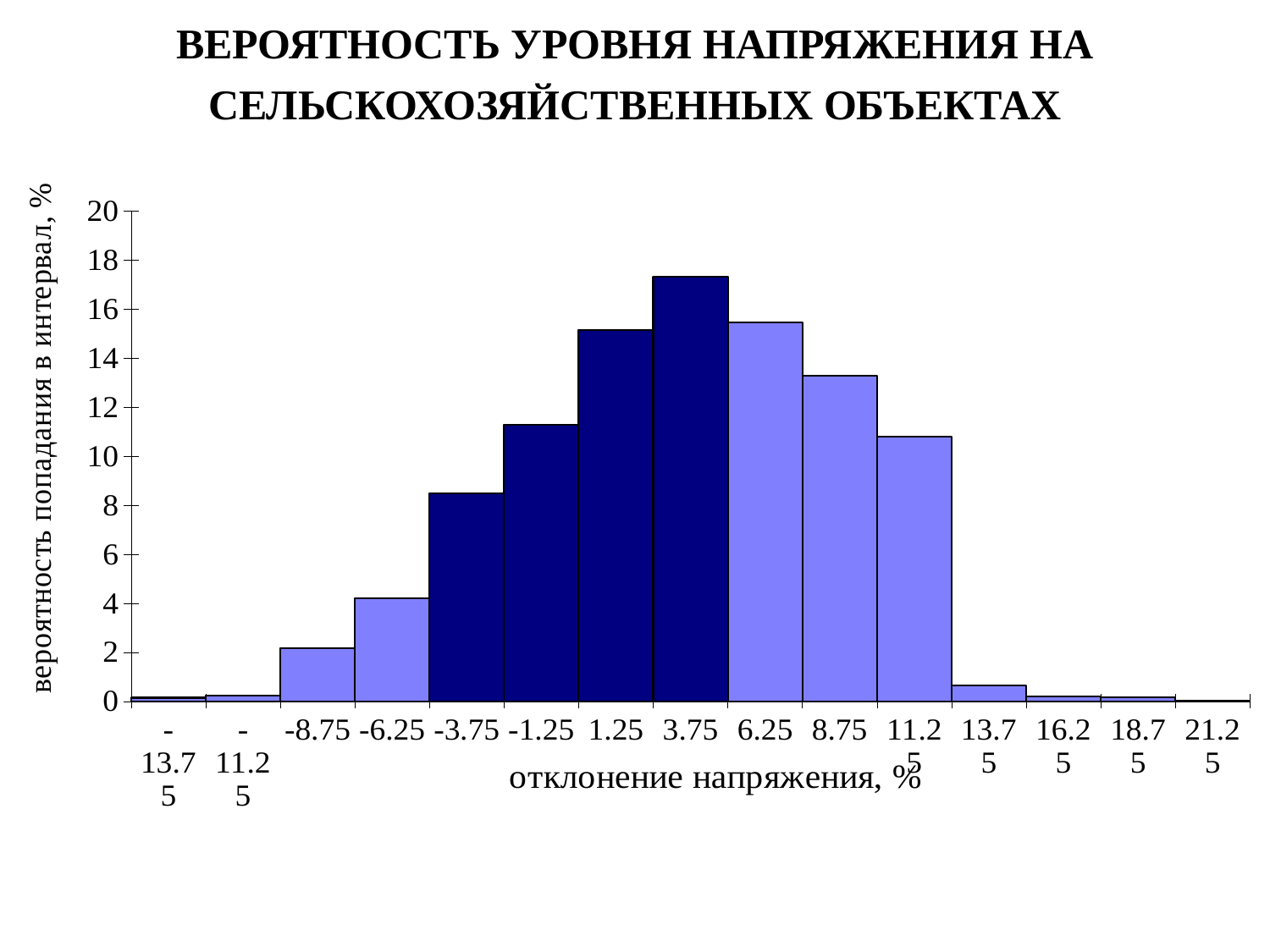
Do the values rise or fall along the x axis from -13.75 to 3.75? rise Which voltage deviation interval has the highest probability? 3.75 What kind of chart is shown on the slide? bar chart Is the value for 8.75 greater or less than 12? greater How many voltage deviation intervals are shown on the x axis? 15 What is the label of the x axis? отклонение напряжения, % Which is larger, the value for 3.75 or the value for 6.25? 3.75 Is the value for -6.25 greater or less than 6? less Is the value for 13.75 greater or less than 2? less Which is larger, the value for -1.25 or the value for 8.75? 8.75